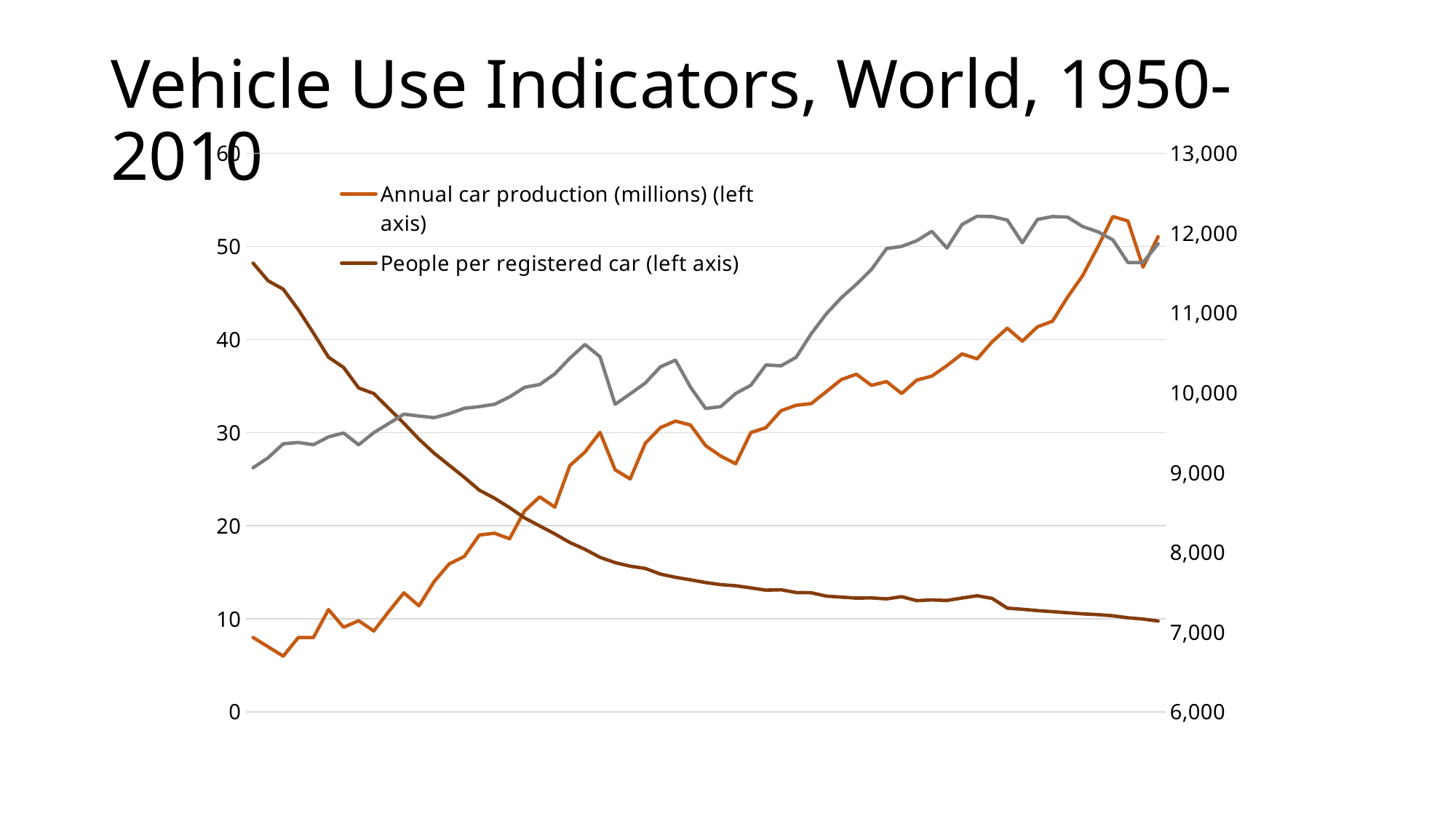
What is the title of the slide? Vehicle Use Indicators, World, 1950-2010 How many series does the legend list? 2 Is the highest point of the Annual car production (millions) line greater or less than 50? greater What is the highest tick value shown on the right-hand axis? 13,000 At the right end of the chart, which is higher: Annual car production (millions) or People per registered car? Annual car production (millions) At the left end of the chart, which is higher: Annual car production (millions) or People per registered car? People per registered car What kind of chart is shown on the slide? line chart Is the starting value of the People per registered car line greater or less than 40? greater Does the People per registered car line generally rise or fall from left to right? fall Does the Annual car production (millions) line generally rise or fall from left to right? rise Is the starting value of the Annual car production (millions) line greater or less than 10? less